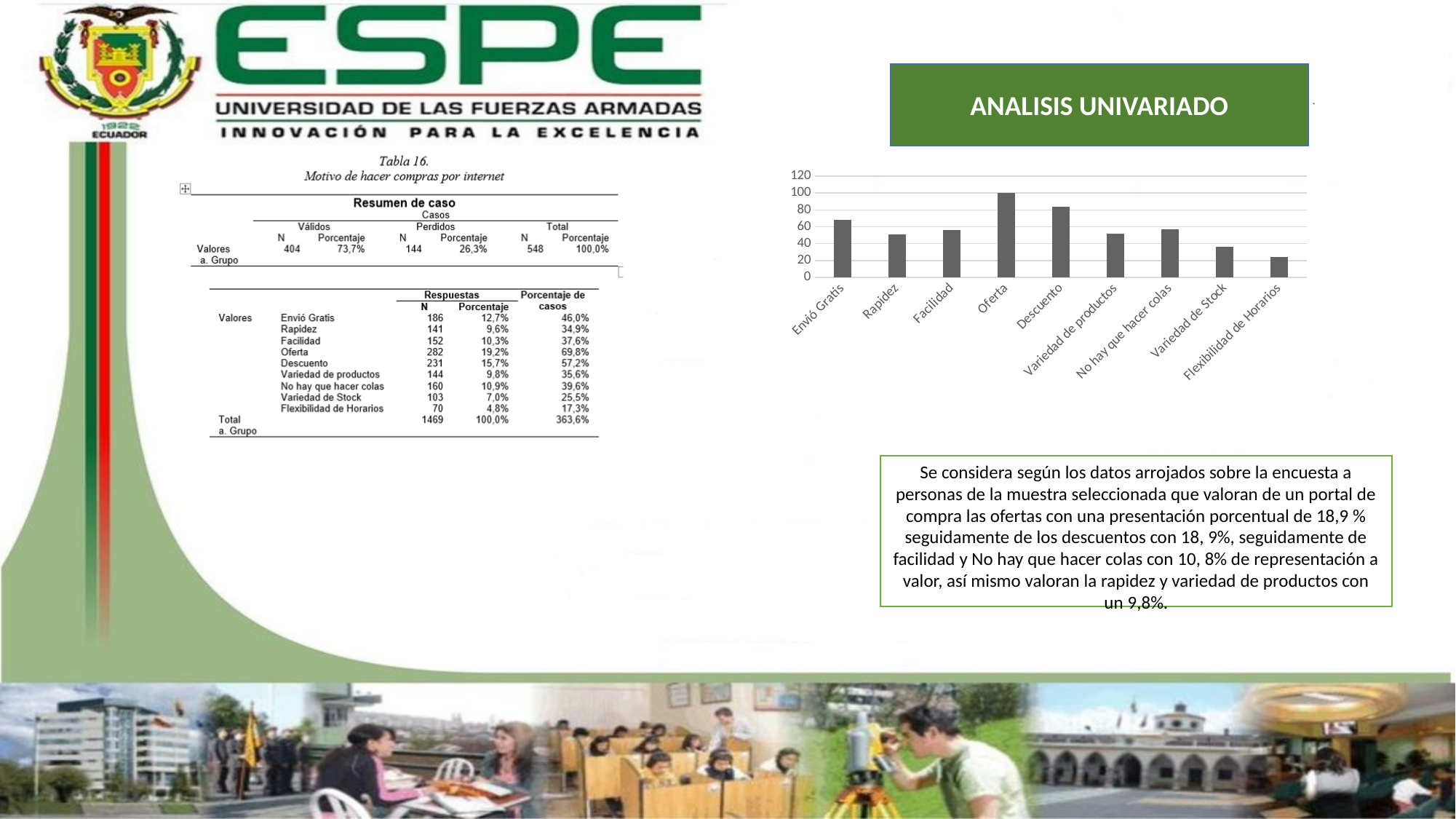
What kind of chart is shown on the slide? bar chart Is the value for Rapidez greater or less than 60? less Is the value for Envío Gratis greater or less than 60? greater Is the value for Descuento greater or less than 60? greater Which bar is taller, Envío Gratis or Rapidez? Envío Gratis Which category has the highest bar in the chart? Oferta Which category has the lowest bar in the chart? Flexibilidad de Horarios What is the highest value shown on the vertical axis of the chart? 120 Which bar is taller, Oferta or Descuento? Oferta How many categories are plotted in the bar chart? 9 Which bar is taller, Descuento or Variedad de Stock? Descuento